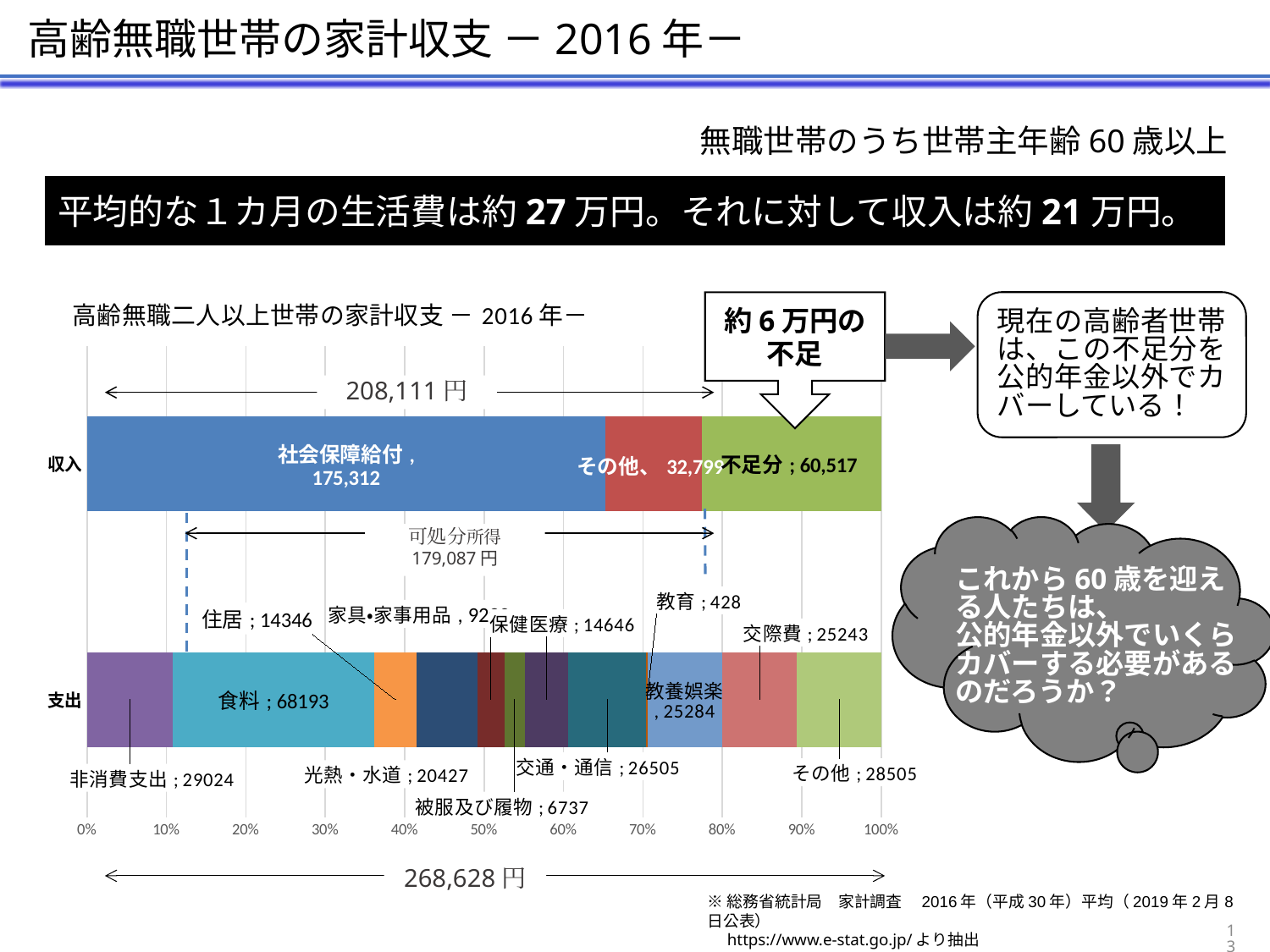
What kind of chart is shown on the slide? Stacked bar chart What is the value of 社会保障給付 in the 収入 bar? 175,312 Which category in the 支出 bar has the largest value? 食料 What is the value of 教育 in the 支出 bar? 428 What total amount is shown by the arrow above the 収入 bar? 208,111 円 What is the value labelled 不足分 in the 収入 bar? 60,517 What is the value of 食料 in the 支出 bar? 68193 How many bars does the chart show? 2 What is the difference between 教養娯楽 and 交際費 in the 支出 bar? 41 What is the difference between 社会保障給付 and その他 in the 収入 bar? 142,513 Which is larger in the 支出 bar, 非消費支出 or その他? 非消費支出 Which category in the 支出 bar has the smallest value? 教育